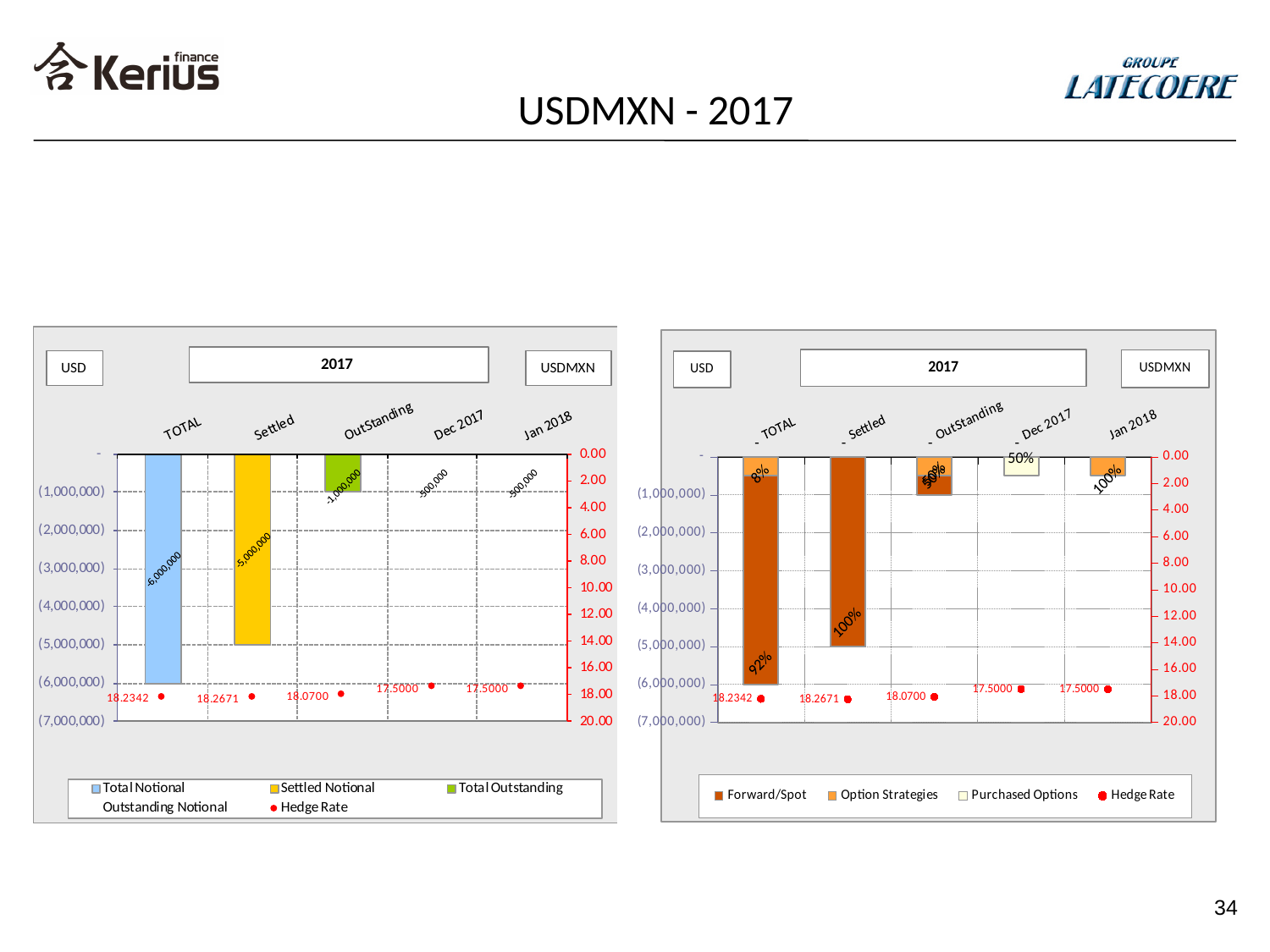
On the left chart, what is the Settled Notional value shown for the Settled category? -5,000,000 On the right chart, how many series does the legend list? 4 On the left chart, what is the Total Outstanding value shown for the OutStanding category? -1,000,000 On the left chart, how many series does the legend list? 5 On the left chart, what is the difference between the Hedge Rate for Settled and the Hedge Rate for TOTAL? 0.0329 On the left chart, what is the Total Notional value shown for the TOTAL category? -6,000,000 On the right chart, what percentage is shown for Forward/Spot in the TOTAL category? 92% How many categories are shown on the x axis of the right chart? 5 On the left chart, what is the Hedge Rate for TOTAL? 18.2342 On the left chart, what is the Hedge Rate for Dec 2017? 17.5000 On the right chart, what percentage is shown for Forward/Spot in the Settled category? 100% On the left chart, which category has the highest Hedge Rate? Settled